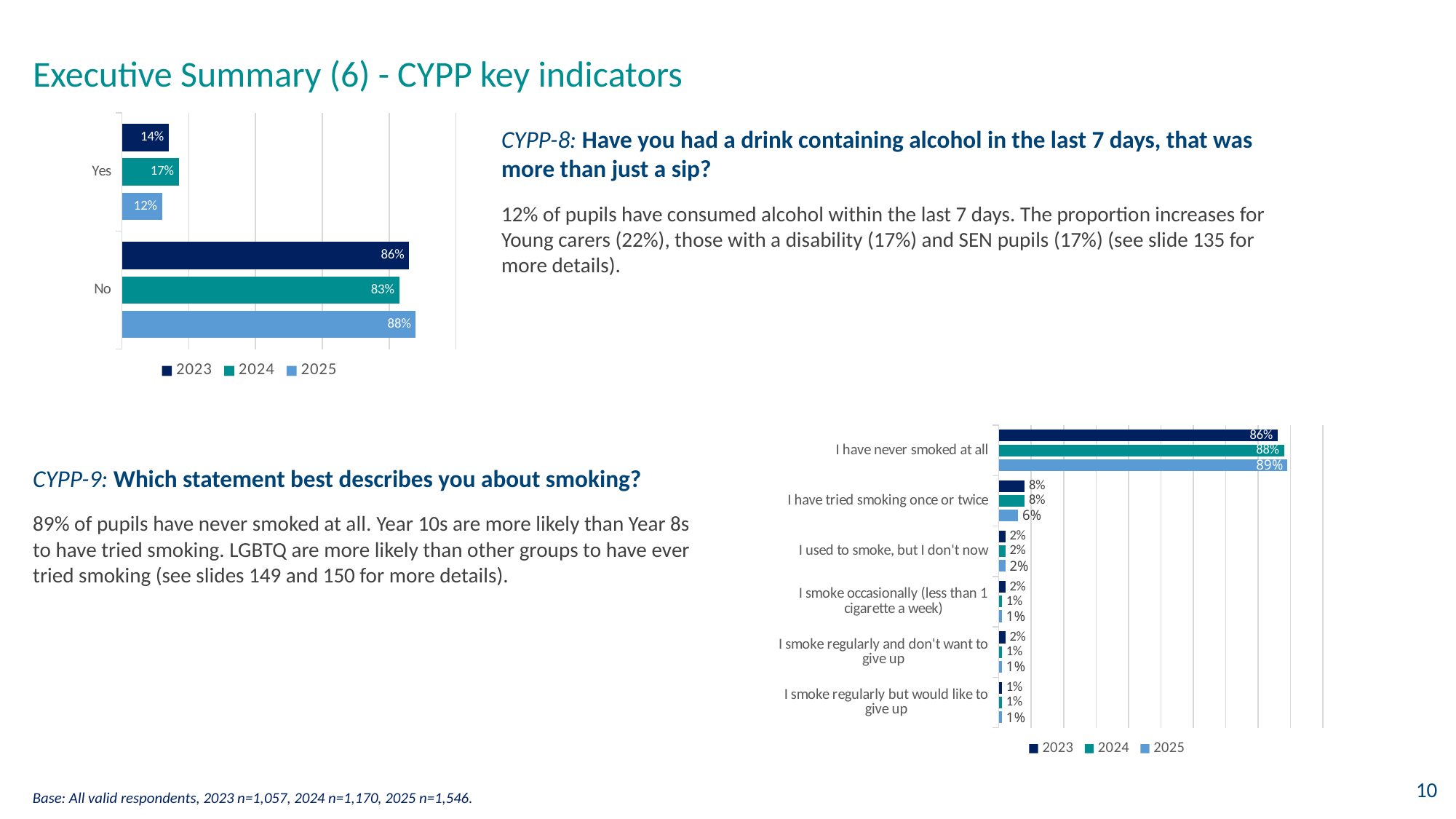
In the bottom-right chart (smoking), which category has the highest values? I have never smoked at all In the bottom-right chart (smoking), what is the 2025 value for 'I have never smoked at all'? 89% In the bottom-right chart (smoking), what is the difference between the 2023 and 2025 values for 'I have tried smoking once or twice'? 2% In the bottom-right chart (smoking), what is the 2025 value for 'I have tried smoking once or twice'? 6% In the bottom-right chart (smoking), is the 2023 value for 'I have never smoked at all' larger or smaller than the 2025 value? Smaller In the top-left chart (alcohol in the last 7 days), which year has the highest value for Yes? 2024 In the top-left chart (alcohol in the last 7 days), what is the 2024 value for No? 83% What kind of chart is the top-left chart (alcohol in the last 7 days)? Bar chart In the bottom-right chart (smoking), how many categories are shown? 6 In the top-left chart (alcohol in the last 7 days), how many series does the legend list? 3 In the top-left chart (alcohol in the last 7 days), what is the difference between the 2023 and 2025 values for No? 2% In the top-left chart (alcohol in the last 7 days), what is the 2025 value for Yes? 12%